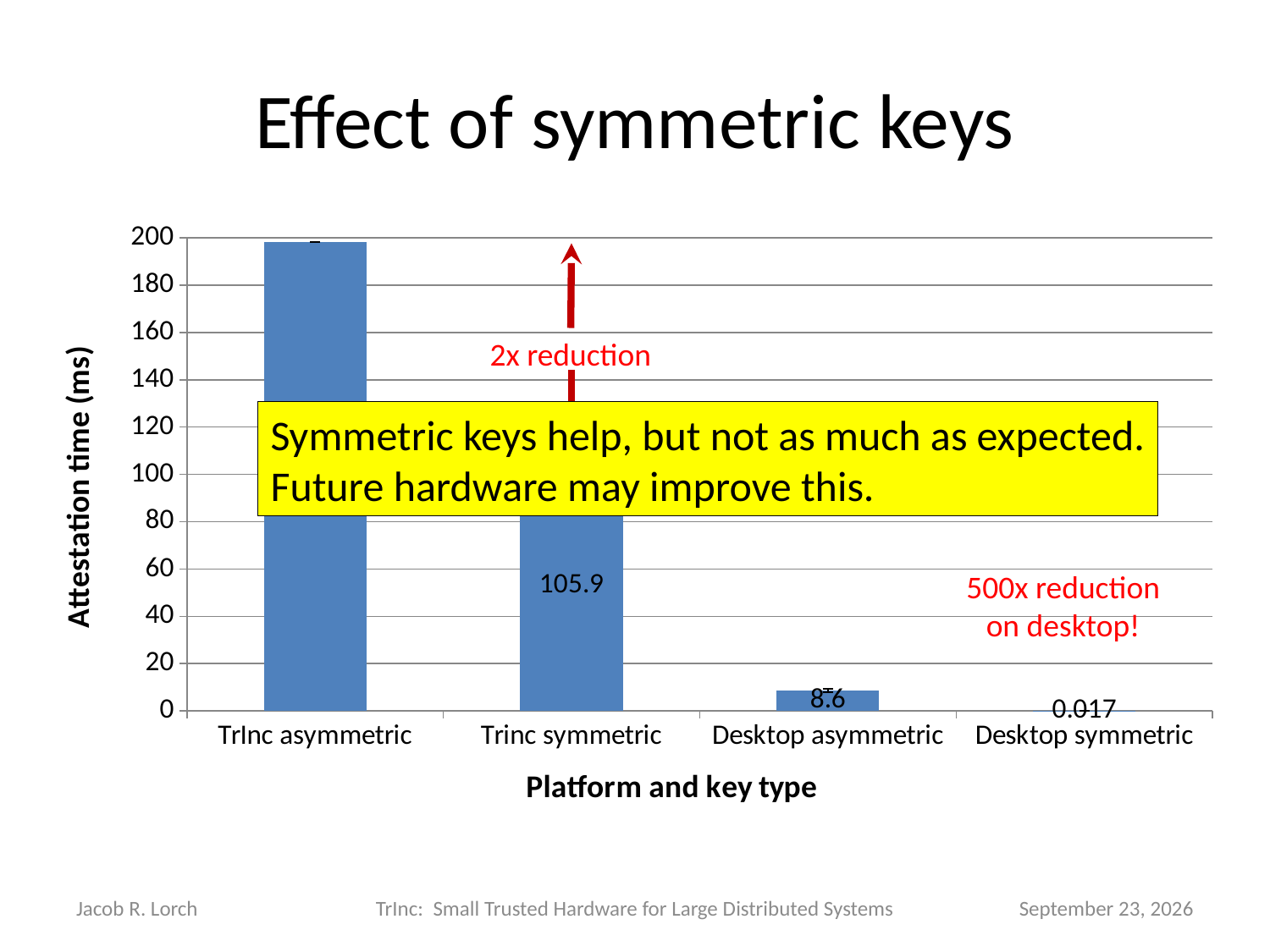
Which platform and key type has the highest attestation time? TrInc asymmetric What is the title of the y axis? Attestation time (ms) What is the attestation time for Desktop symmetric? 0.017 What is the attestation time for Desktop asymmetric? 8.6 Which platform and key type has the lowest attestation time? Desktop symmetric How many platform and key type categories are shown on the x axis? 4 What is the difference in attestation time between Trinc symmetric and Desktop asymmetric? 97.3 Is the attestation time for TrInc asymmetric greater or less than 180? greater Do the attestation times rise or fall from left to right across the categories? fall What is the attestation time for Trinc symmetric? 105.9 Which has a larger attestation time, TrInc asymmetric or Trinc symmetric? TrInc asymmetric What kind of chart is shown on the slide? bar chart